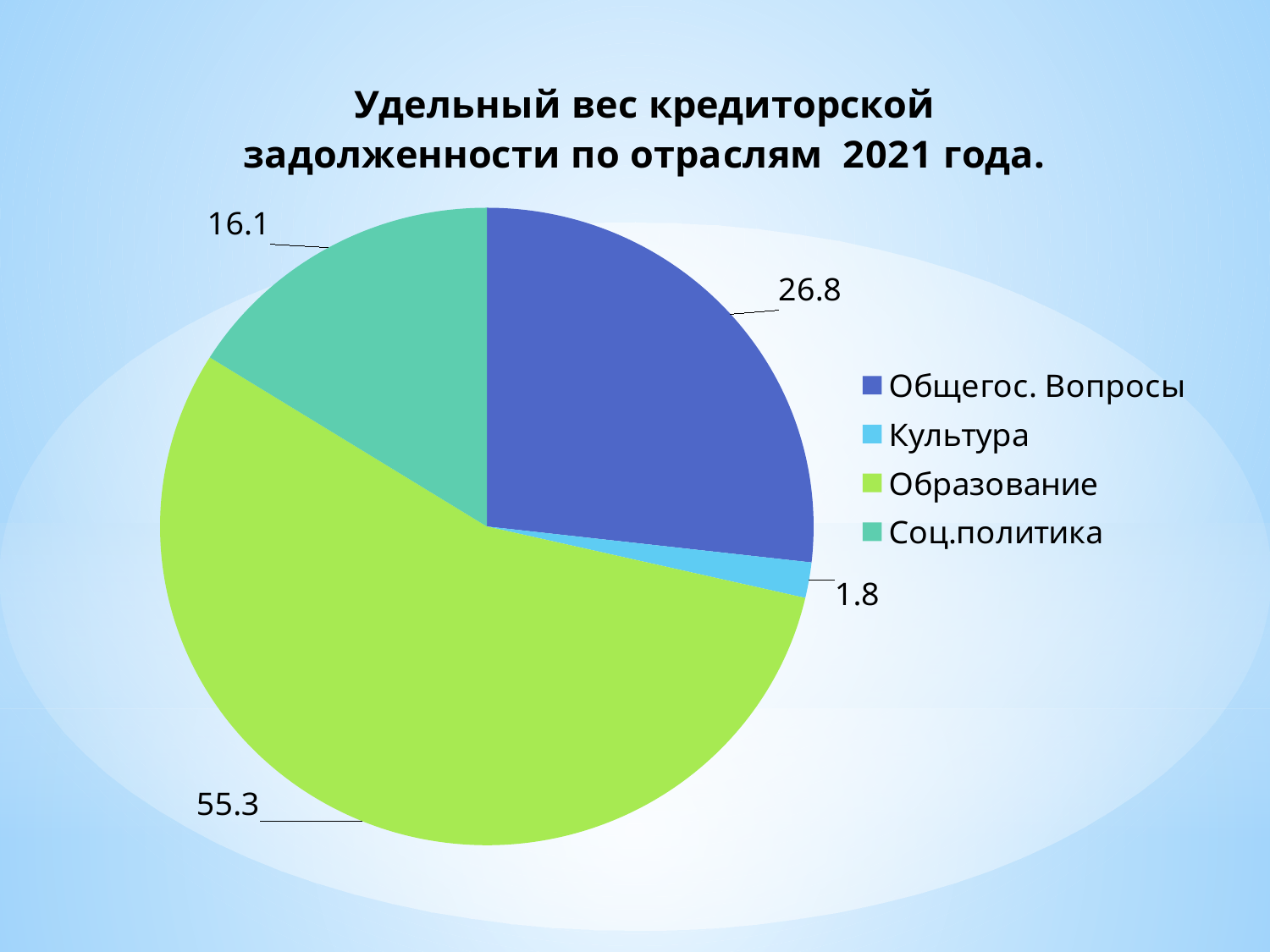
Which category has the largest share of the pie? Образование How many categories does the pie chart have? 4 What colour is the slice for Соц.политика? teal What is the value for Соц.политика? 16.1 What is the title of the chart? Удельный вес кредиторской задолженности по отраслям 2021 года. Which category has the smallest share of the pie? Культура Which is larger, the value for Общегос. Вопросы or the value for Соц.политика? Общегос. Вопросы What is the value for Образование? 55.3 What is the difference between the values for Образование and Общегос. Вопросы? 28.5 What is the value for Культура? 1.8 What type of chart is shown on the slide? pie chart What is the value for Общегос. Вопросы? 26.8